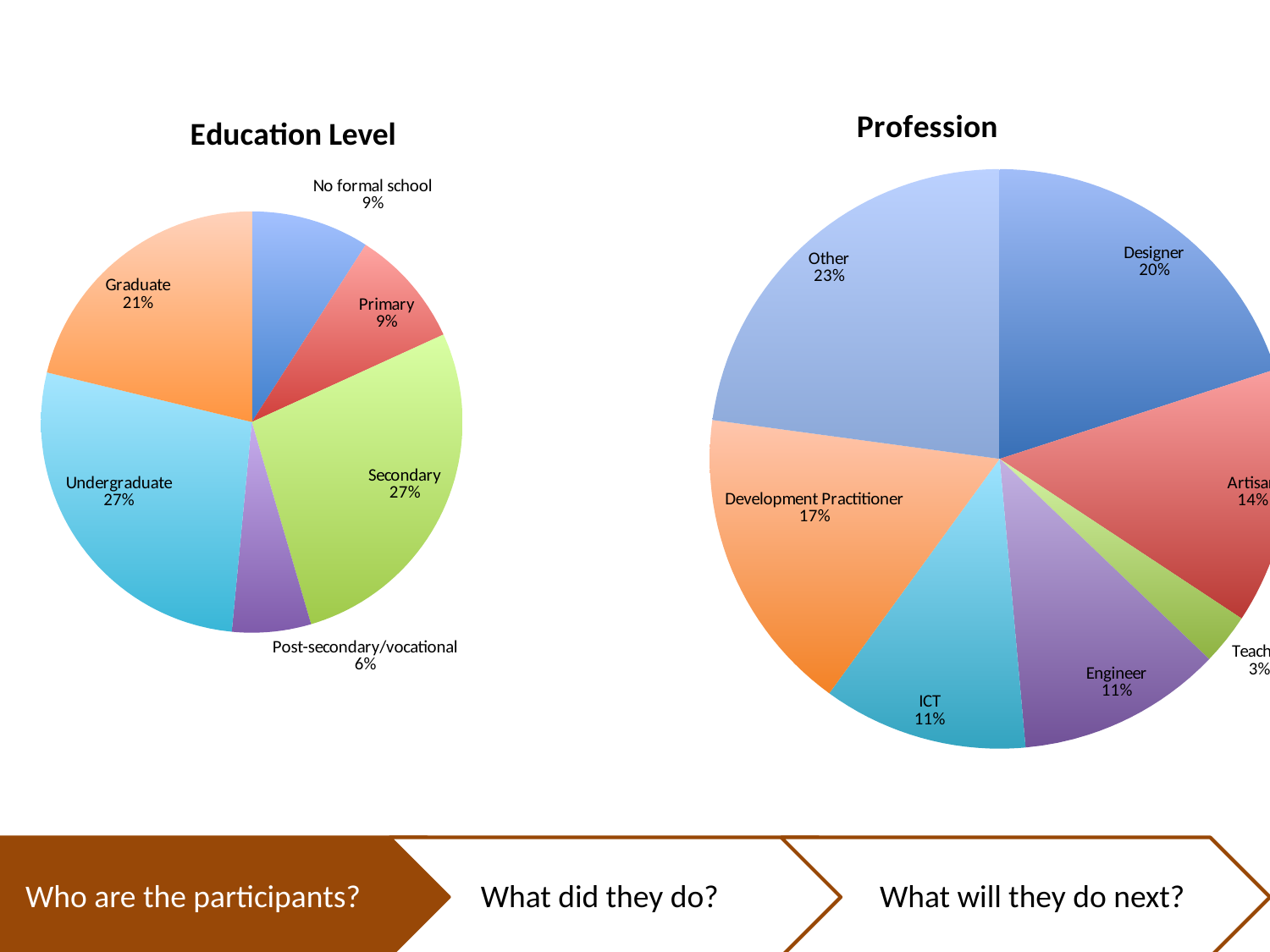
In the Profession chart, what percentage of participants are Development Practitioners? 17% How many slices does the Profession chart have? 7 In the Education Level chart, what share of the pie is Post-secondary/vocational? 6% In the Education Level chart, what is the difference between the Undergraduate share and the Graduate share? 6% In the Profession chart, what is the difference between the Designer share and the ICT share? 9% In the Profession chart, which profession has the largest share? Other What type of chart is the Education Level chart? Pie chart How many categories are shown in the Education Level chart? 6 In the Education Level chart, what percentage of participants have a Graduate education? 21% In the Education Level chart, which category has the smallest share? Post-secondary/vocational In the Profession chart, which is larger: Engineer or Designer? Designer In the Education Level chart, which is larger: Secondary or Primary? Secondary